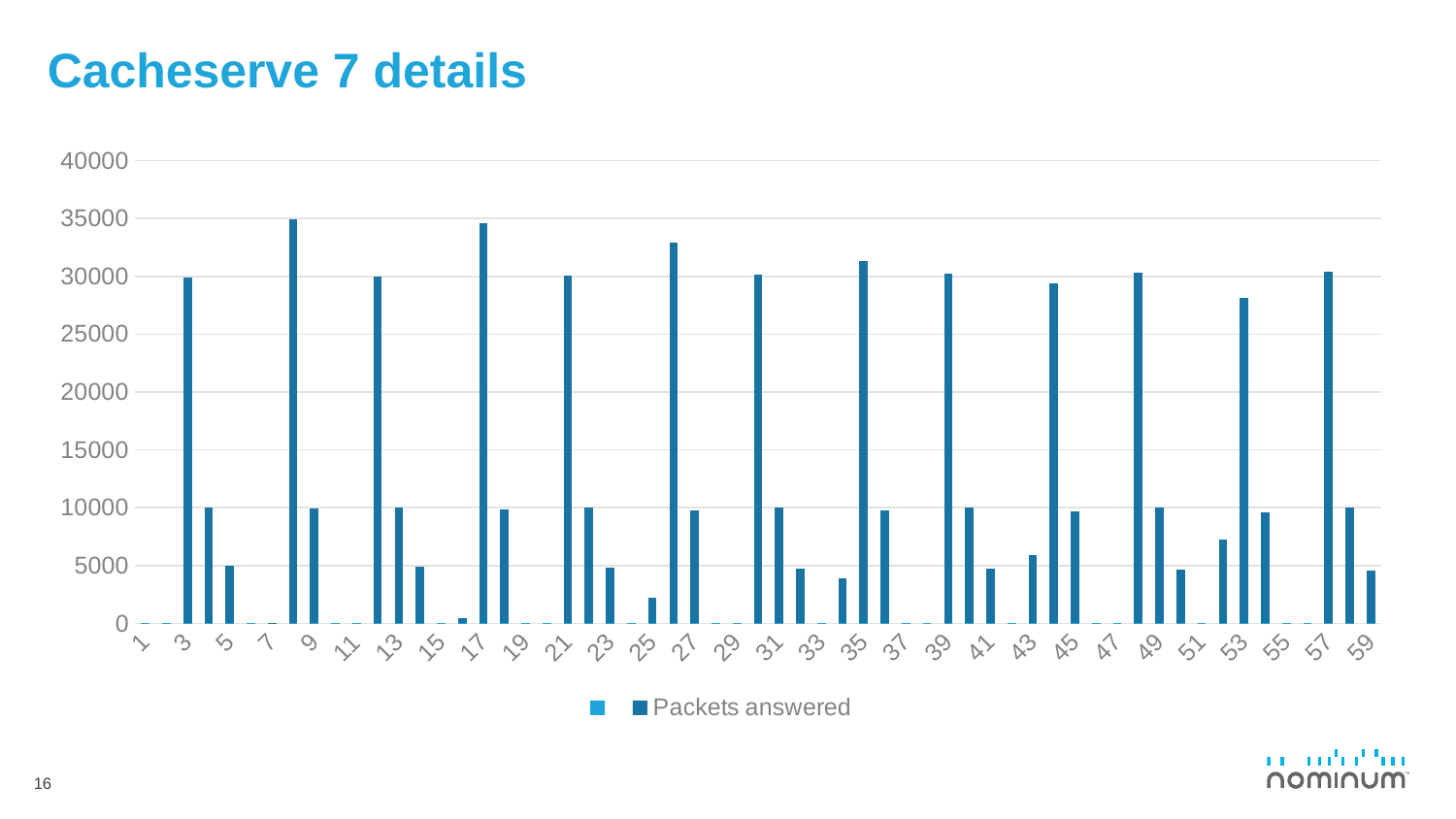
Is the Packets answered value at category 3 greater or less than 25000? greater What type of chart is shown on the slide? bar chart Which has the larger Packets answered value, category 17 or category 5? 17 Is the Packets answered value at category 17 greater or less than 30000? greater How many series does the legend list? 2 What is the title of the slide containing the chart? Cacheserve 7 details Is the Packets answered value at category 53 greater or less than 20000? greater What is the readable series name in the chart legend? Packets answered Which has the larger Packets answered value, category 25 or category 3? 3